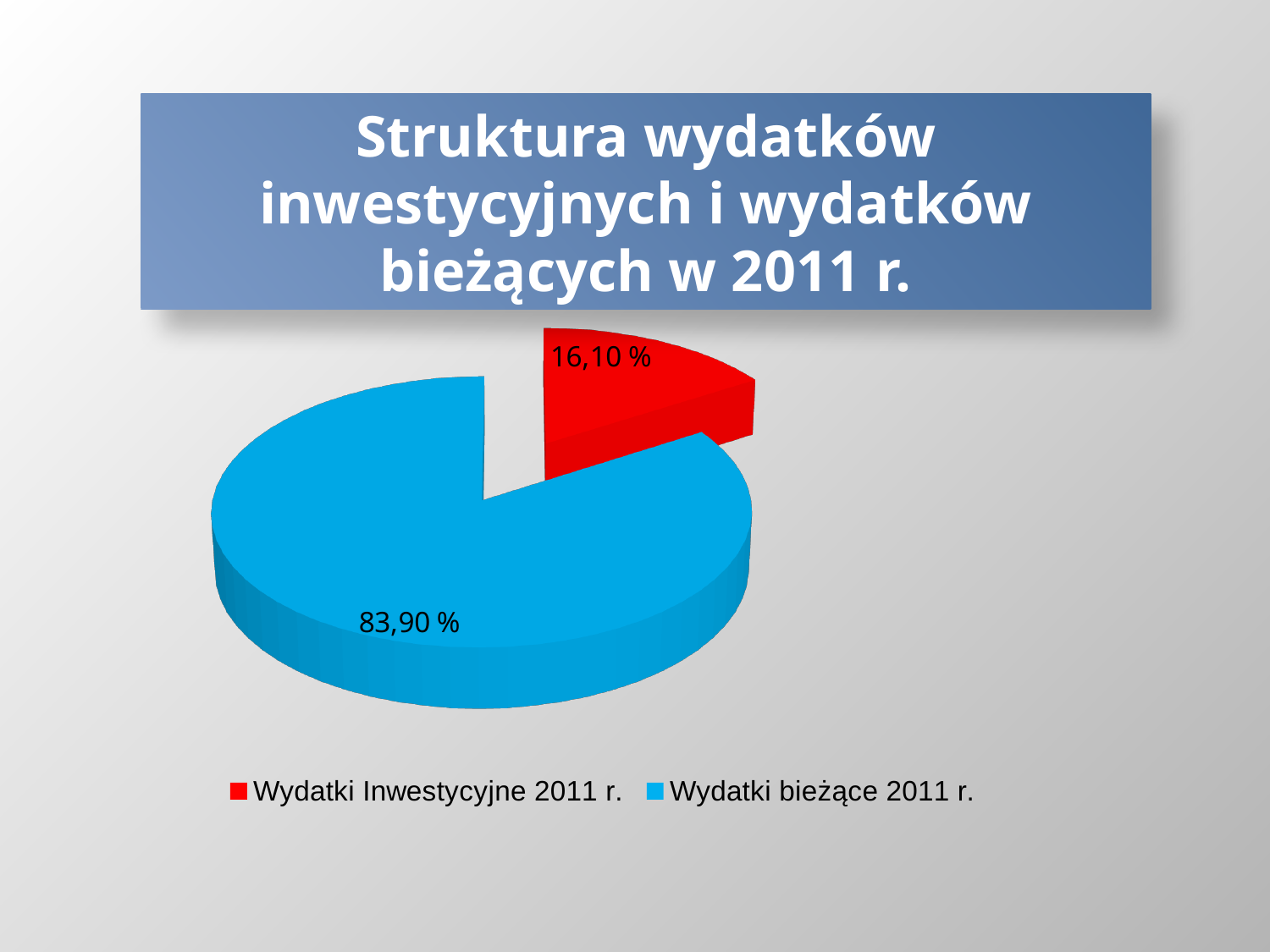
What is the title of the chart on the slide? Struktura wydatków inwestycyjnych i wydatków bieżących w 2011 r. Which category has the smallest slice of the pie? Wydatki Inwestycyjne 2011 r. What share of the pie does Wydatki Inwestycyjne 2011 r. represent? 16,10 % What is the value for Wydatki bieżące 2011 r.? 83,90 % What is the value for Wydatki Inwestycyjne 2011 r.? 16,10 % Which category has the largest slice of the pie? Wydatki bieżące 2011 r. How many slices does the pie chart have? 2 Which is larger: Wydatki Inwestycyjne 2011 r. or Wydatki bieżące 2011 r.? Wydatki bieżące 2011 r. What colour is the slice for Wydatki Inwestycyjne 2011 r.? red What kind of chart is shown on the slide? pie chart What is the difference between the values for Wydatki bieżące 2011 r. and Wydatki Inwestycyjne 2011 r.? 67,80 % How many entries does the legend list? 2